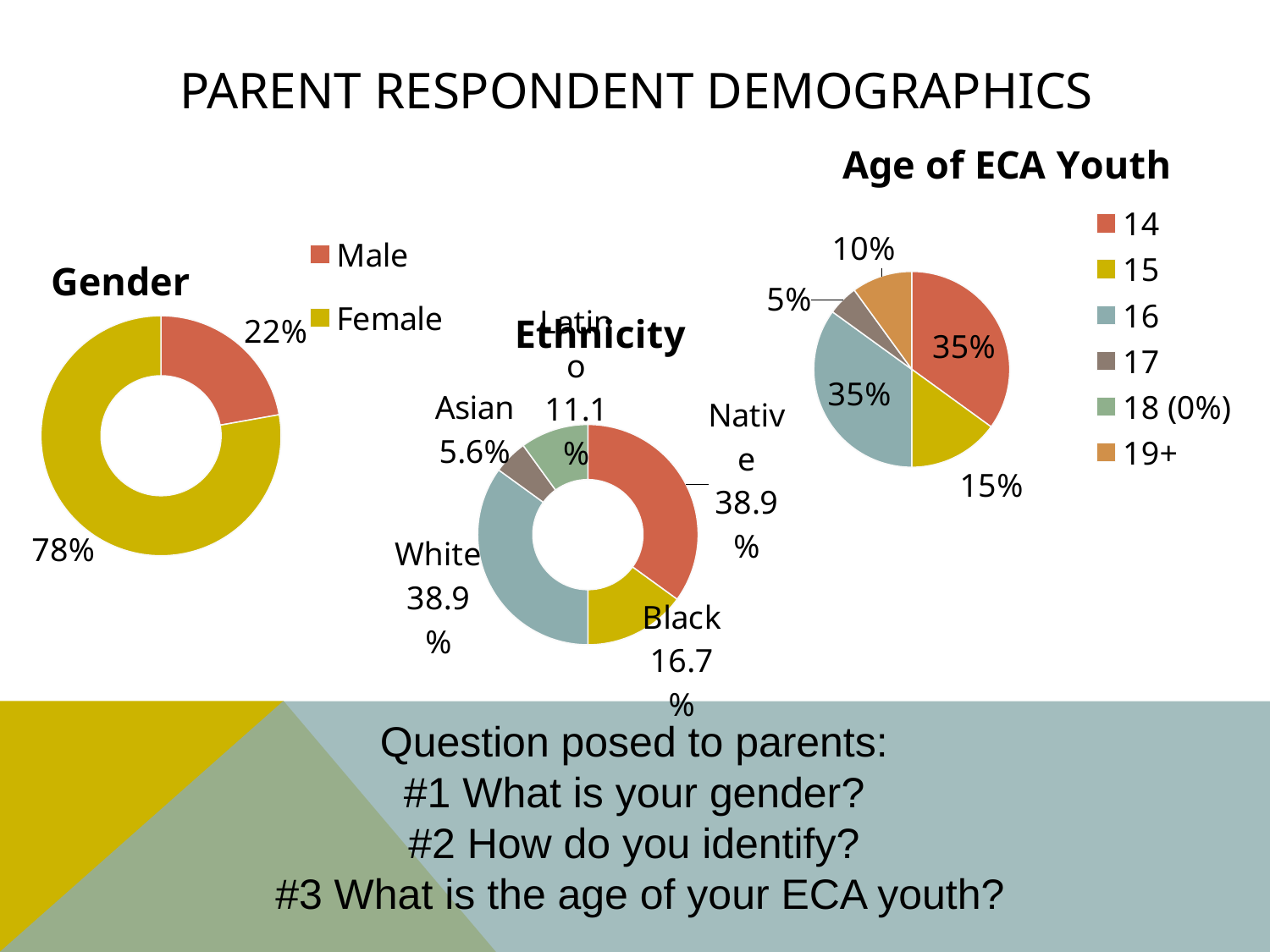
What kind of chart is the Age of ECA Youth chart? Pie chart In the Age of ECA Youth chart, what percentage of youth are age 19+? 10% In the Age of ECA Youth chart, how many age categories does the legend list? 6 In the Gender chart, what is the difference between the Female and Male percentages? 56% In the Ethnicity chart, which category has the smallest share? Asian In the Ethnicity chart, how many ethnicity categories are shown? 5 In the Gender chart, what percentage of parent respondents are Male? 22% In the Gender chart, what percentage of parent respondents are Female? 78% In the Age of ECA Youth chart, what percentage of youth are age 15? 15% In the Ethnicity chart, what percentage of respondents identify as Latino? 11.1% In the Ethnicity chart, which is larger, the share for Native or the share for Black? Native In the Ethnicity chart, what percentage of respondents identify as Black? 16.7%